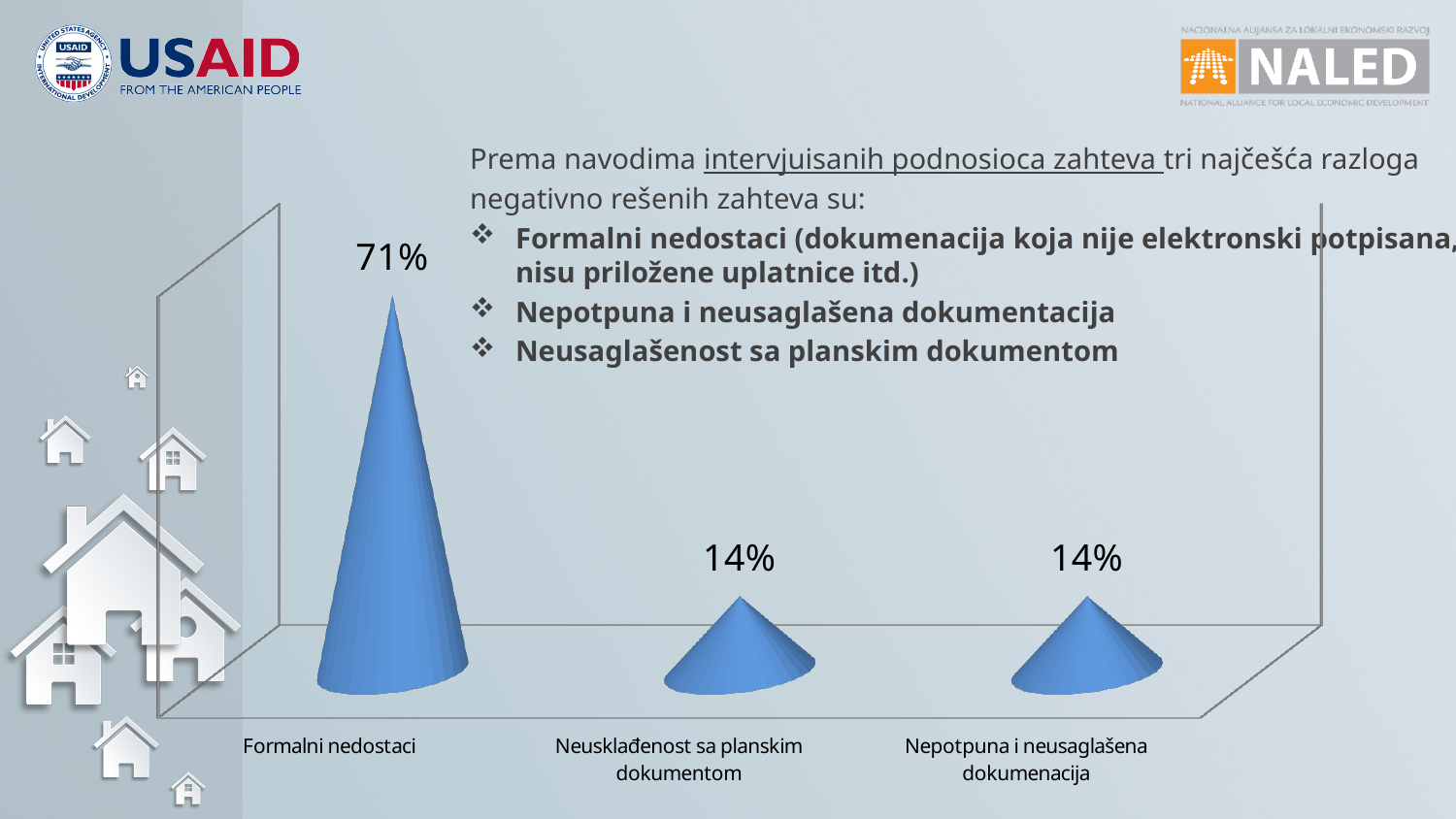
What is the value for Formalni nedostaci? 71% What is the total of the three values shown in the chart? 99% What kind of chart is shown on the slide? Bar chart What is the difference between the value for Formalni nedostaci and the value for Neusklađenost sa planskim dokumentom? 57% Which category has the highest value? Formalni nedostaci What colour are the bars in the chart? Blue Which category is labelled first on the x axis? Formalni nedostaci What is the value for Nepotpuna i neusaglašena dokumentacija? 14% How many categories are shown in the chart? 3 What is the value for Neusklađenost sa planskim dokumentom? 14% Which is larger, the value for Formalni nedostaci or the value for Nepotpuna i neusaglašena dokumentacija? Formalni nedostaci Do the values rise or fall from the first category to the second category along the x axis? Fall